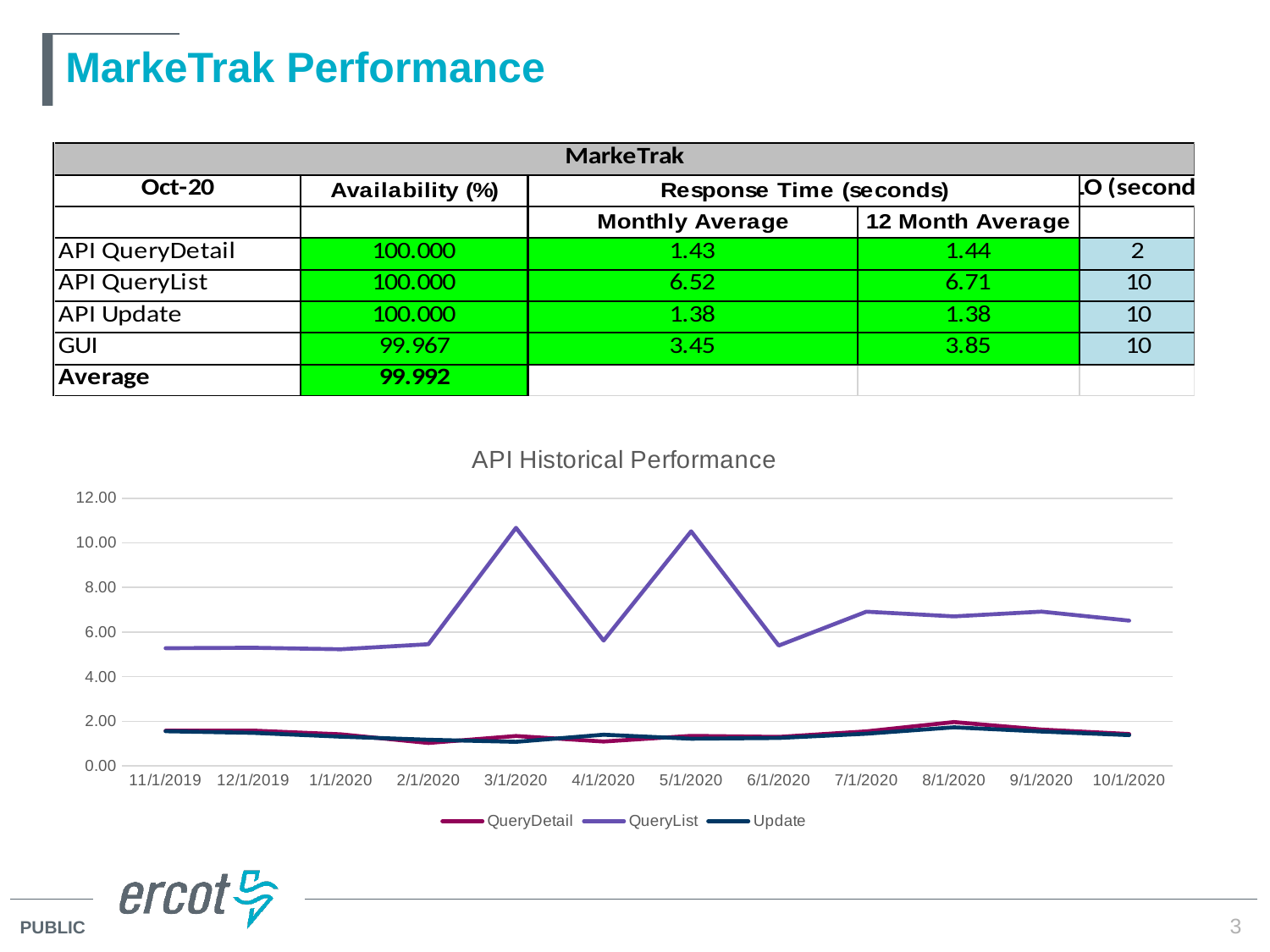
What is the title of the line chart on the slide? API Historical Performance In the API Historical Performance chart, is the QueryList value for 10/1/2020 greater or less than 6.00? greater What kind of chart is the API Historical Performance chart? line chart In the API Historical Performance chart, which series has the highest values across the whole period? QueryList How many series does the legend of the API Historical Performance chart list? 3 In the API Historical Performance chart, is the QueryList value for 11/1/2019 greater or less than 6.00? less How many dates are shown on the x axis of the API Historical Performance chart? 12 In the API Historical Performance chart, which series has the larger value on 5/1/2020, QueryList or Update? QueryList In the API Historical Performance chart, does the QueryList series rise or fall from 1/1/2020 to 3/1/2020? rise In the API Historical Performance chart, is the Update value for 8/1/2020 greater or less than 2.00? less